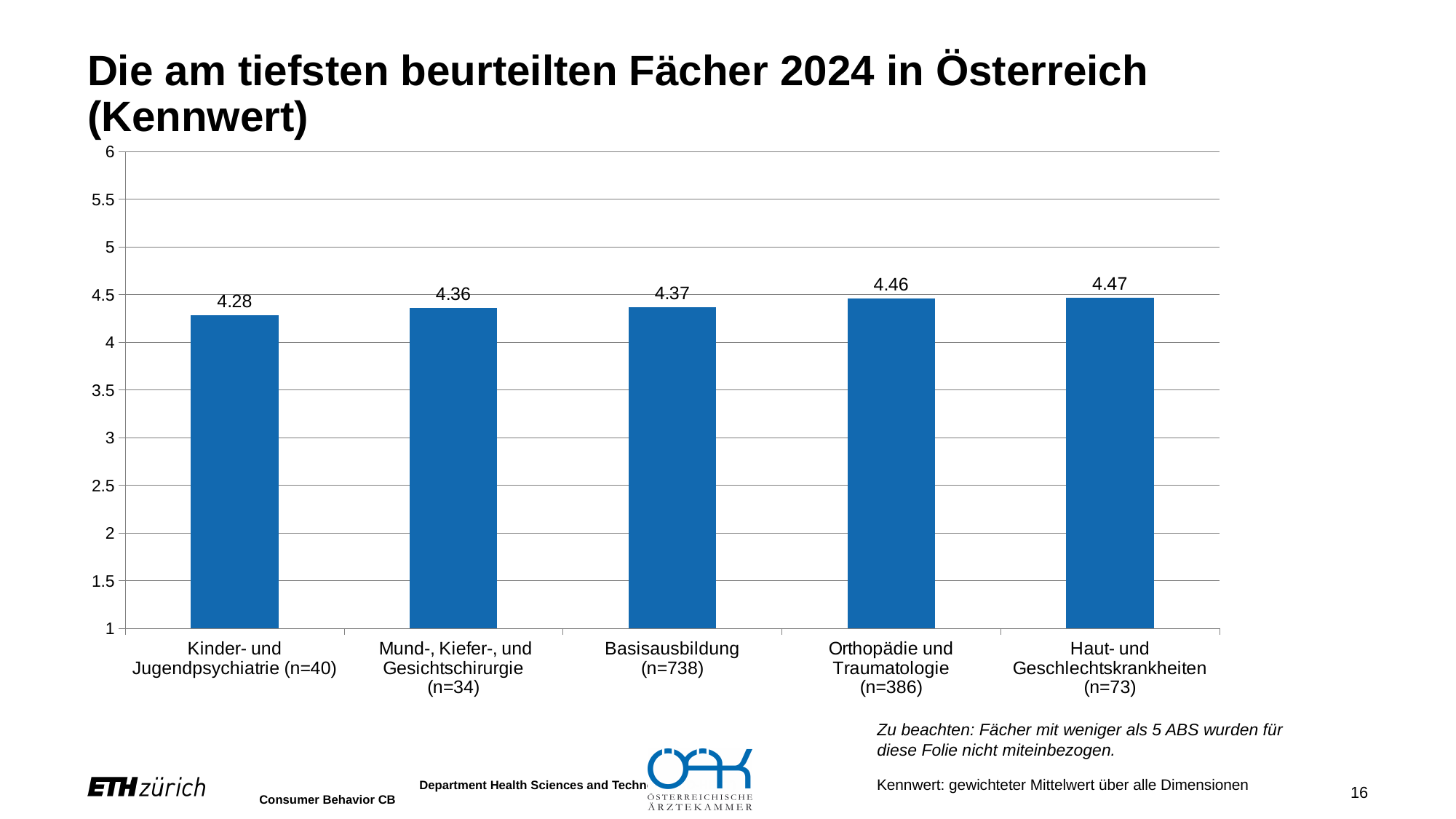
Which is larger: the value for Mund-, Kiefer-, und Gesichtschirurgie (n=34) or the value for Kinder- und Jugendpsychiatrie (n=40)? Mund-, Kiefer-, und Gesichtschirurgie (n=34) What is the value for Haut- und Geschlechtskrankheiten (n=73)? 4.47 What is the value for Orthopädie und Traumatologie (n=386)? 4.46 What is the value for Basisausbildung (n=738)? 4.37 What is the difference between the values for Orthopädie und Traumatologie (n=386) and Mund-, Kiefer-, und Gesichtschirurgie (n=34)? 0.10 What is the difference between the values for Haut- und Geschlechtskrankheiten (n=73) and Kinder- und Jugendpsychiatrie (n=40)? 0.19 Do the values rise or fall from left to right along the x axis? Rise What kind of chart is shown on the slide? Bar chart Which category has the highest value? Haut- und Geschlechtskrankheiten (n=73) Which category has the lowest value? Kinder- und Jugendpsychiatrie (n=40) How many categories are shown in the chart? 5 What is the value for Kinder- und Jugendpsychiatrie (n=40)? 4.28